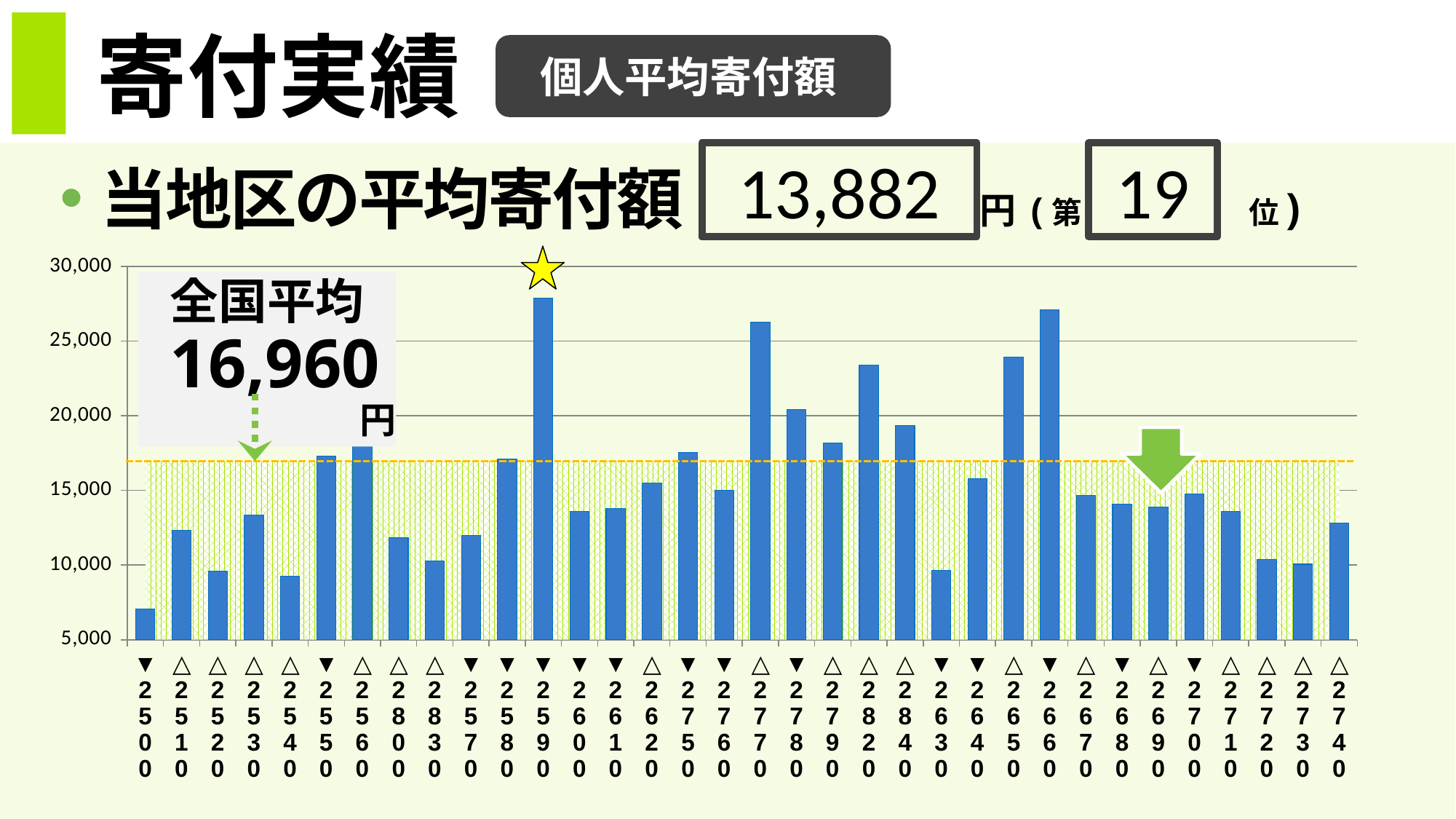
What kind of chart is shown on the slide? bar chart What is the highest value shown on the vertical axis? 30,000 Which district has the lowest bar in the chart? 2500 Which district has the highest bar in the chart? 2590 Which is larger, the value for district 2770 or district 2780? 2770 Is the value for district 2500 greater or less than 10,000? less Which is larger, the value for district 2500 or district 2510? 2510 Is the value for district 2770 greater or less than 25,000? greater Is the value for district 2590 greater or less than 25,000? greater How many bars (districts) are plotted in the chart? 34 What value is given for the national average (全国平均) marked by the dashed line? 16,960円